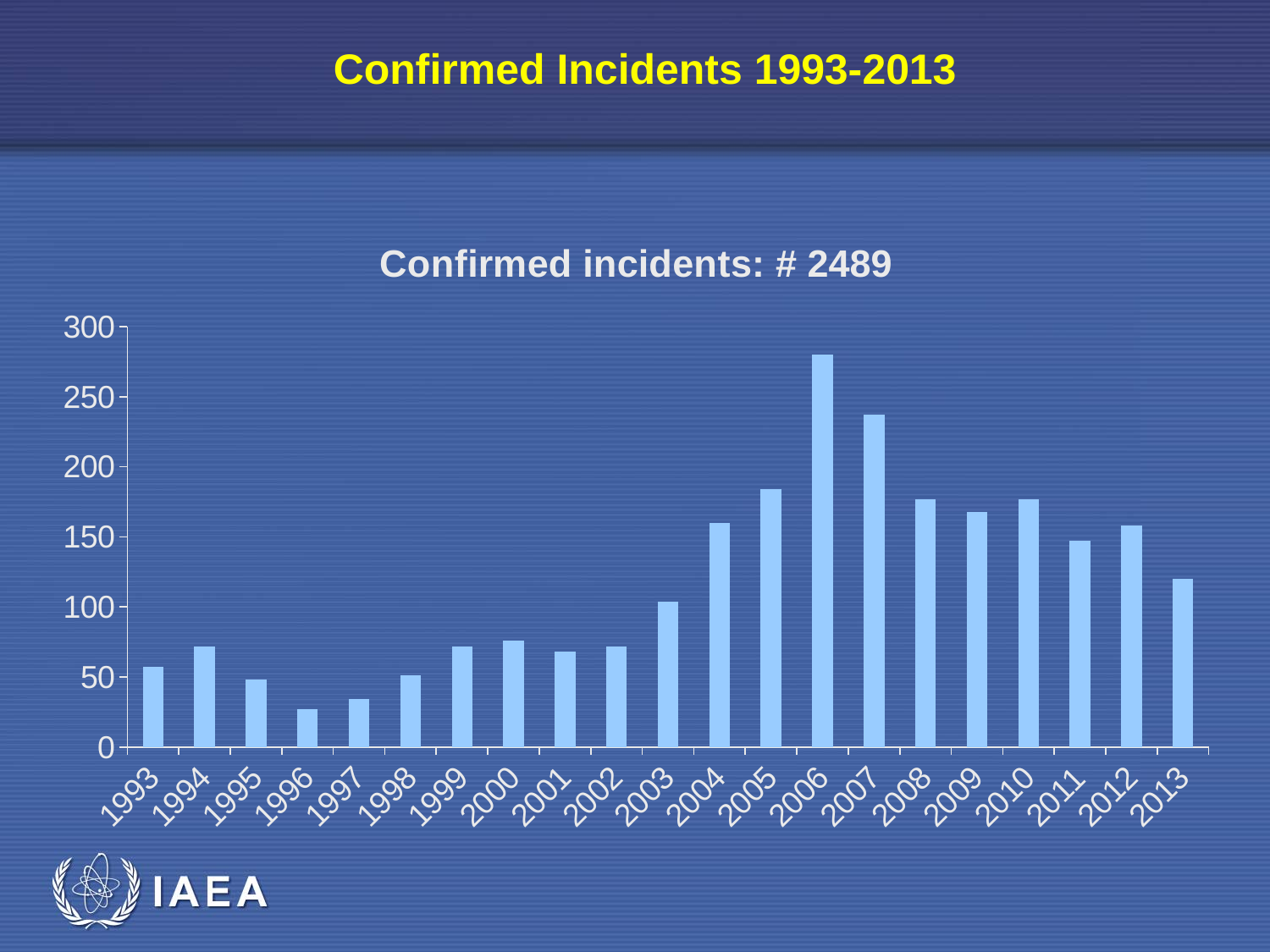
Is the value for 2013 greater or less than 150? less What kind of chart is shown on the slide? bar chart How many years are shown on the x axis of the chart? 21 Which year has the larger value, 2006 or 2007? 2006 Is the value for 2006 greater or less than 250? greater Which year has the lowest number of confirmed incidents? 1996 Which year has the highest number of confirmed incidents? 2006 Is the value for 1996 greater or less than 50? less Do the values rise or fall from 2003 to 2006? rise What total number of confirmed incidents is stated above the chart? 2489 Which year has the larger value, 2003 or 2004? 2004